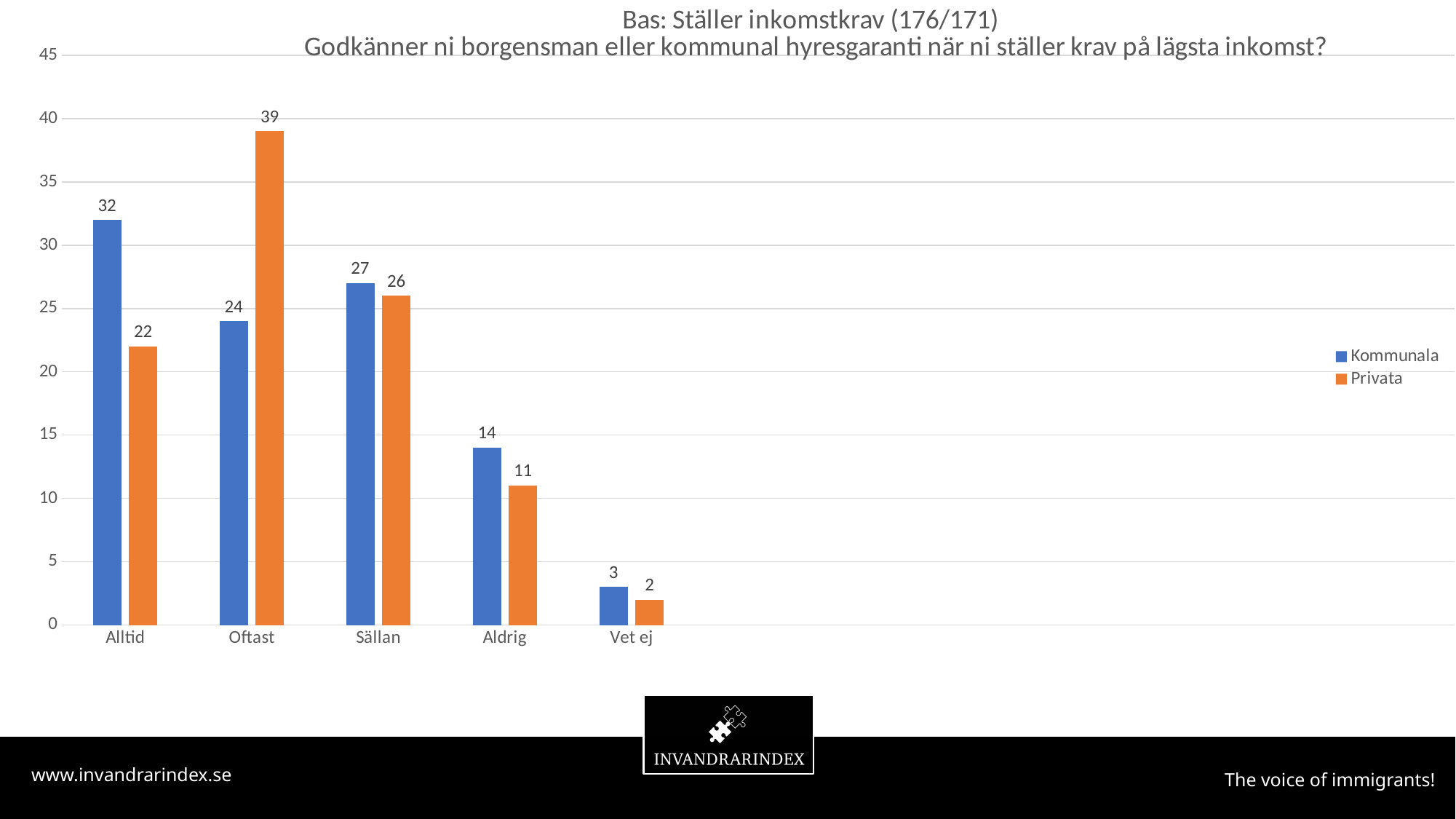
What is the difference between the Privata and Kommunala values in the Oftast category? 15 Which is larger in the Alltid category, Kommunala or Privata? Kommunala Which category has the lowest value for the Kommunala series? Vet ej What is the value for Privata in the Oftast category? 39 What is the difference between the Kommunala values for Alltid and Aldrig? 18 What kind of chart is shown on the slide? Bar chart How many series does the legend list? 2 Which category has the highest value for the Privata series? Oftast How many categories are shown on the x axis? 5 Which series is shown in orange? Privata What is the value for Privata in the Aldrig category? 11 What is the value for Kommunala in the Alltid category? 32